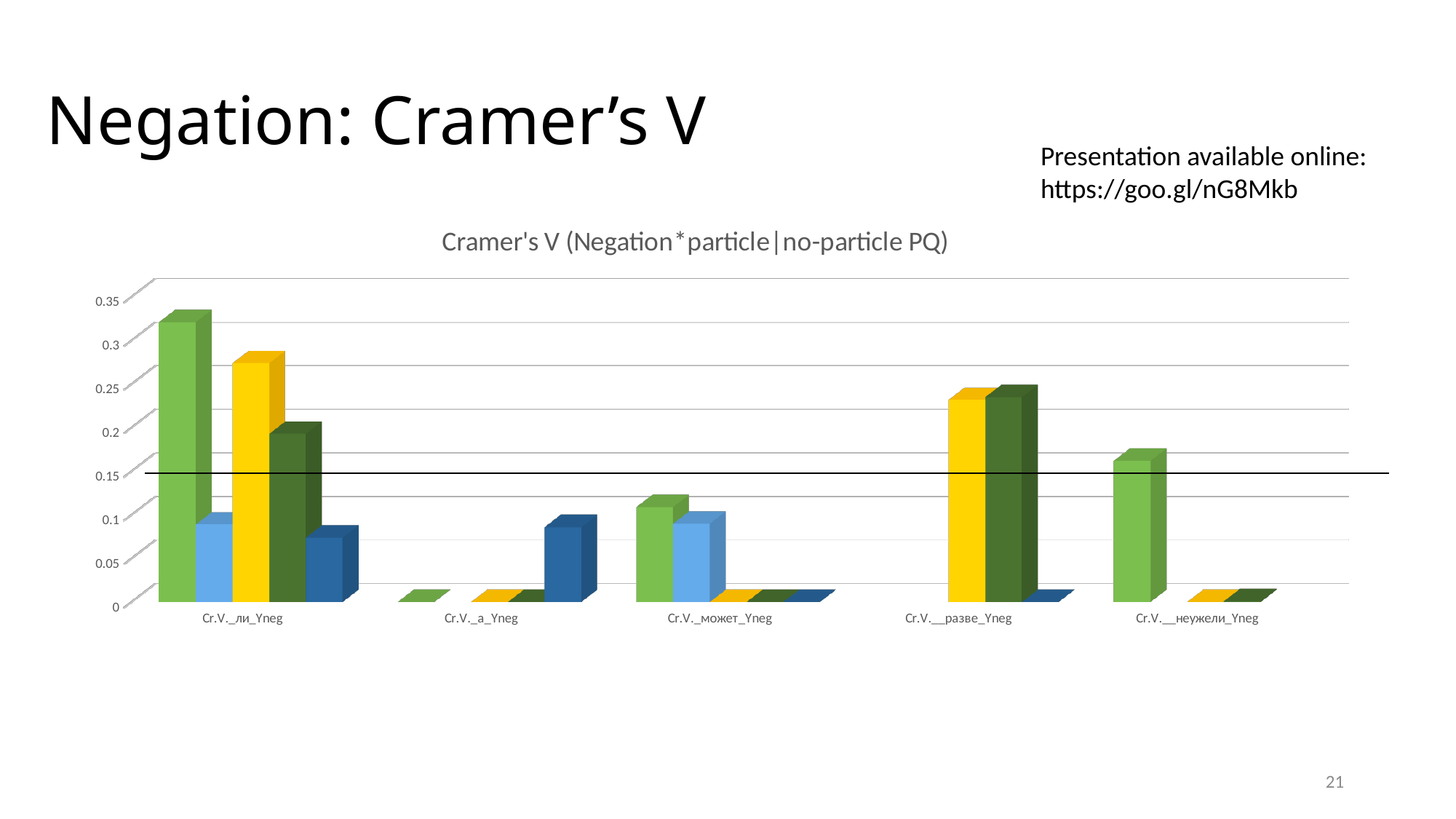
Is the value of the yellow bar for Cr.V.__разве_Yneg greater or less than 0.2? greater How many categories are shown on the x axis of the chart? 5 Is the value of the light green bar for Cr.V._ли_Yneg greater or less than 0.25? greater Is the value of the dark blue bar for Cr.V._a_Yneg greater or less than 0.15? less What kind of chart is shown on the slide? bar chart Which category contains the tallest bar in the chart? Cr.V._ли_Yneg What is the title of the chart? Cramer's V (Negation*particle|no-particle PQ) Which is larger: the light green bar for Cr.V._ли_Yneg or the light green bar for Cr.V.__неужели_Yneg? Cr.V._ли_Yneg